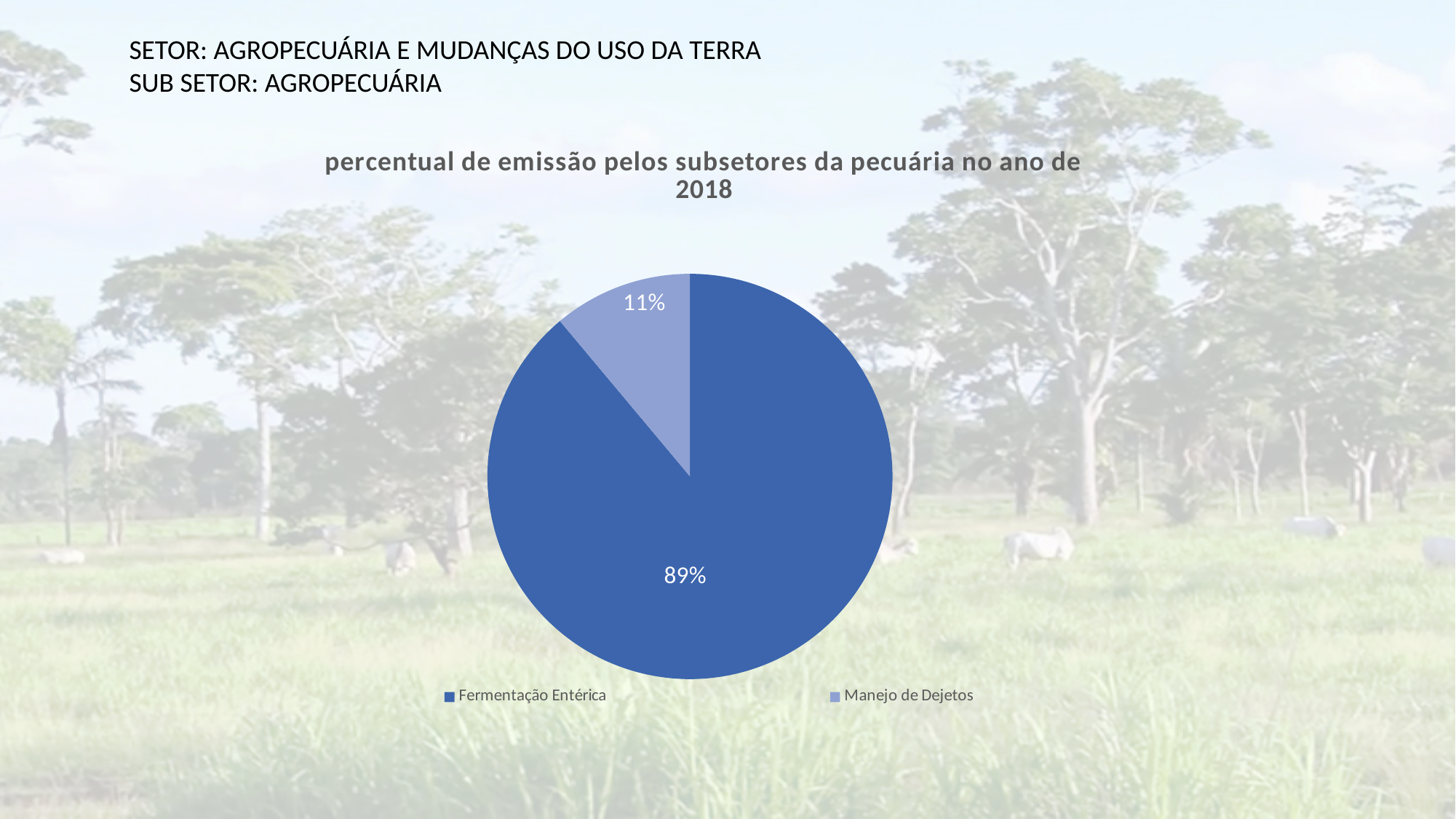
Which category has the largest slice of the pie? Fermentação Entérica Which year does the chart title refer to? 2018 What is the title of the chart? percentual de emissão pelos subsetores da pecuária no ano de 2018 How many entries does the legend list? 2 What share of the pie does Manejo de Dejetos represent? 11% How many categories are shown in the pie chart? 2 Which category has the smallest slice of the pie? Manejo de Dejetos Which is larger, the slice for Fermentação Entérica or the slice for Manejo de Dejetos? Fermentação Entérica What is the difference in percentage points between Fermentação Entérica and Manejo de Dejetos? 78 What kind of chart is shown on the slide? Pie chart What share of the pie does Fermentação Entérica represent? 89%